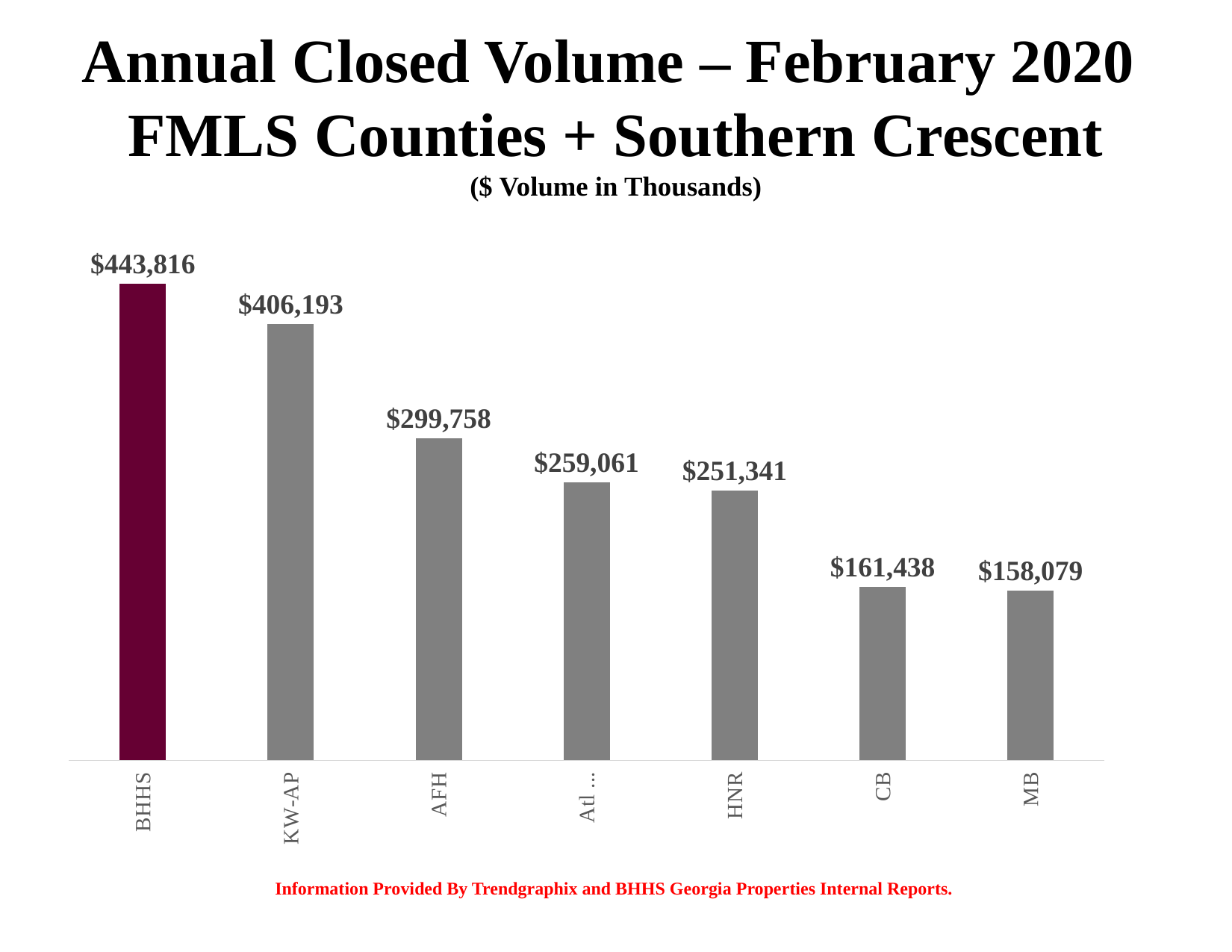
What is the annual closed volume for BHHS? $443,816 What is the annual closed volume for HNR? $251,341 What is the difference between the closed volume of AFH and HNR? $48,417 Which company has the highest annual closed volume? BHHS Which company has the lowest annual closed volume? MB Which has a larger annual closed volume, AFH or CB? AFH What type of chart is shown on the slide? Bar chart What is the difference between the closed volume of BHHS and KW-AP? $37,623 Which bar is highlighted in a different colour from the others? BHHS How many companies are shown in the chart? 7 What is the annual closed volume for MB? $158,079 What is the annual closed volume for KW-AP? $406,193